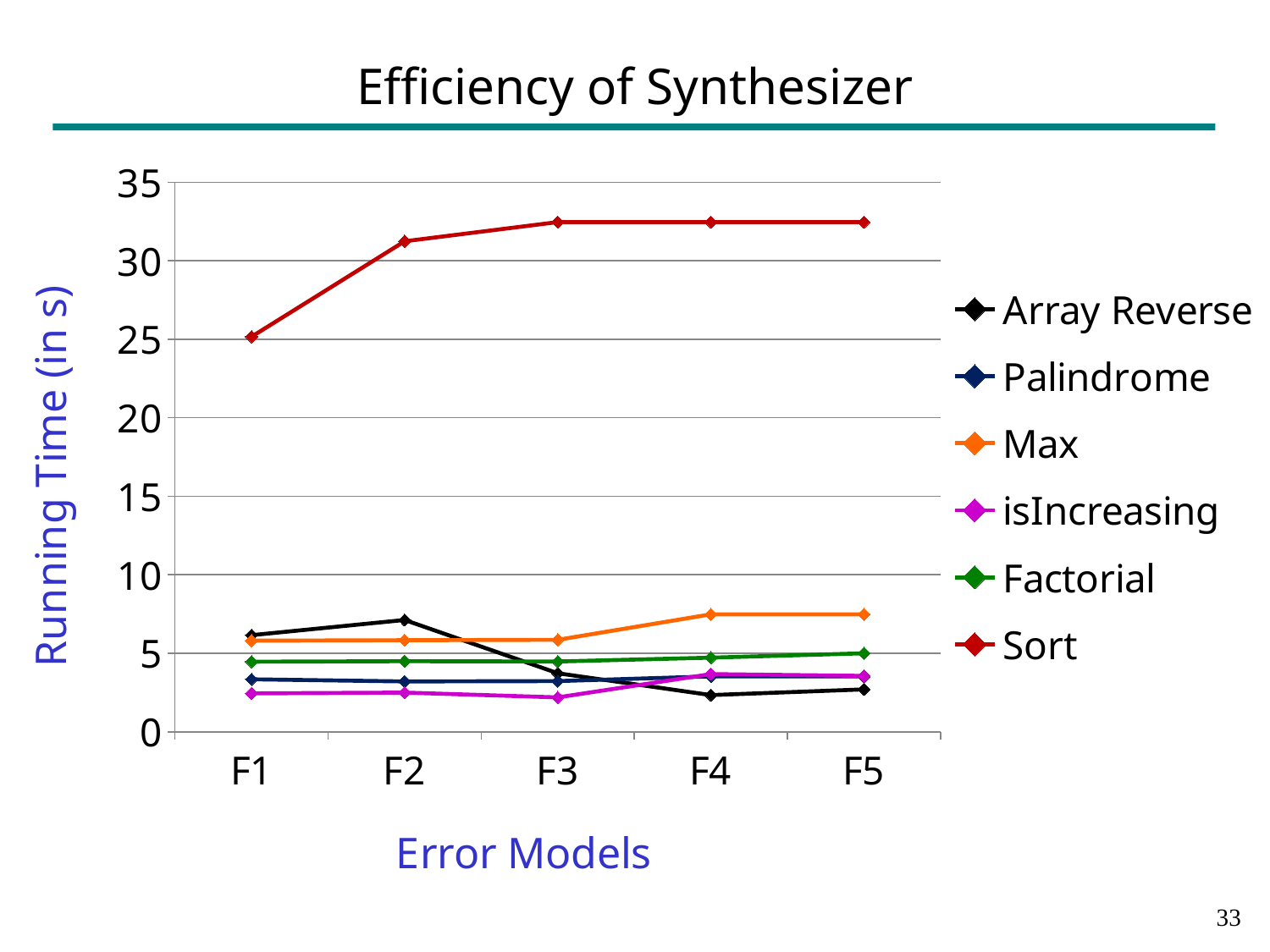
Which series has the highest running time at F5? Sort Does the running time for Sort rise or fall from F1 to F3? rise Which series has the lowest running time at F4? Array Reverse What kind of chart is shown on the slide? line chart For Array Reverse, is the running time larger at F2 or at F4? F2 How many series does the legend list? 6 Is the running time for Array Reverse at F2 greater or less than 5? greater How many error models are plotted along the x axis? 5 What is the title of the y axis? Running Time (in s) Is the running time for Sort at F1 greater or less than 20? greater At F4, which series has the larger running time, Max or Factorial? Max Is the running time for Sort at F3 greater or less than 30? greater